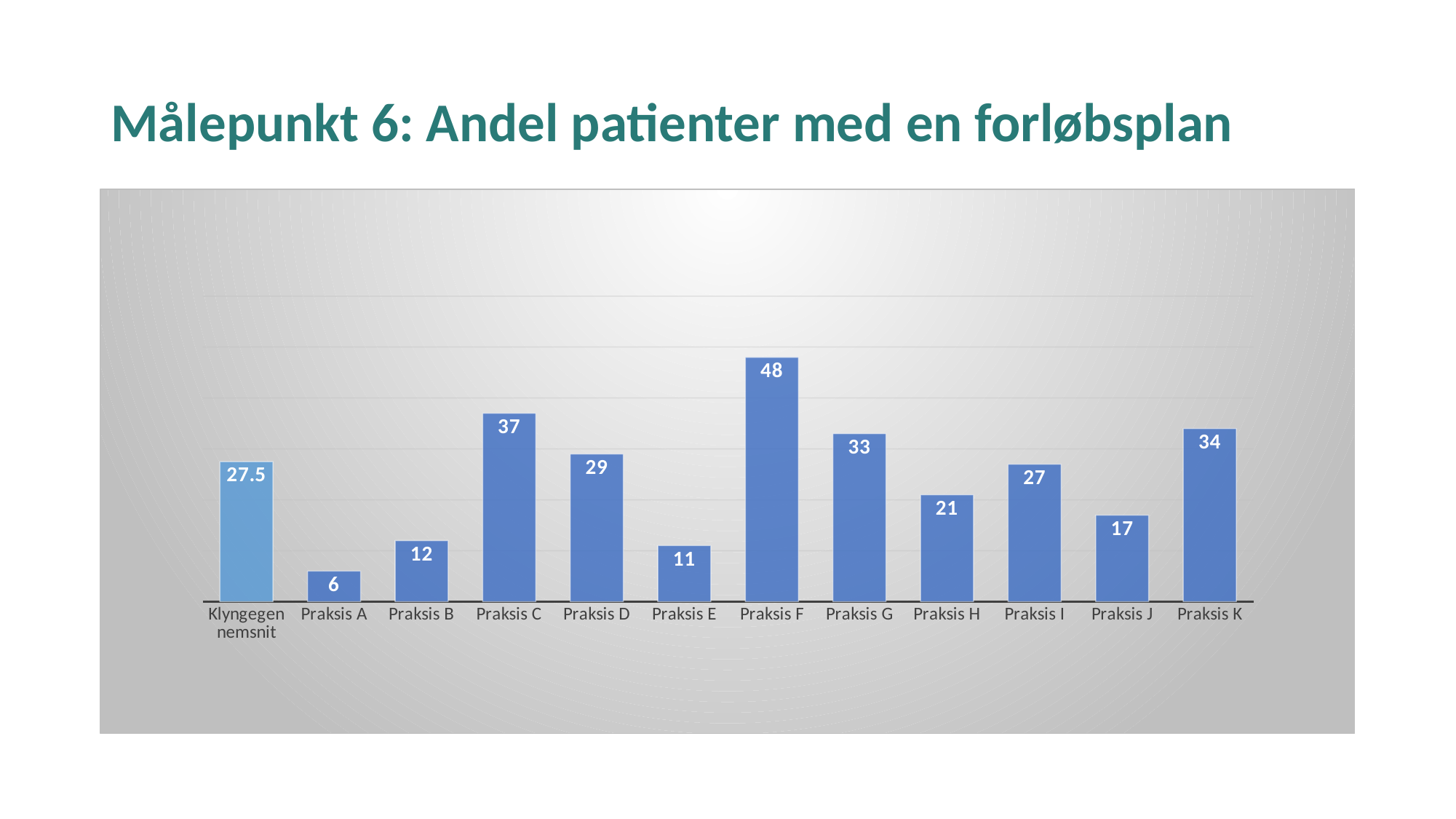
What is the value for Praksis F? 48 What is the value for Praksis J? 17 Which category has the highest value? Praksis F Which is larger, the value for Praksis G or the value for Praksis K? Praksis K What kind of chart is shown on the slide? Bar chart What is the difference between the values for Praksis C and Praksis D? 8 What is the title of the slide? Målepunkt 6: Andel patienter med en forløbsplan Which is larger, the value for Praksis B or the value for Praksis E? Praksis B What is the difference between the values for Praksis F and Praksis A? 42 How many categories are shown on the x axis? 12 Which category has the lowest value? Praksis A What is the value for Klyngegennemsnit? 27.5